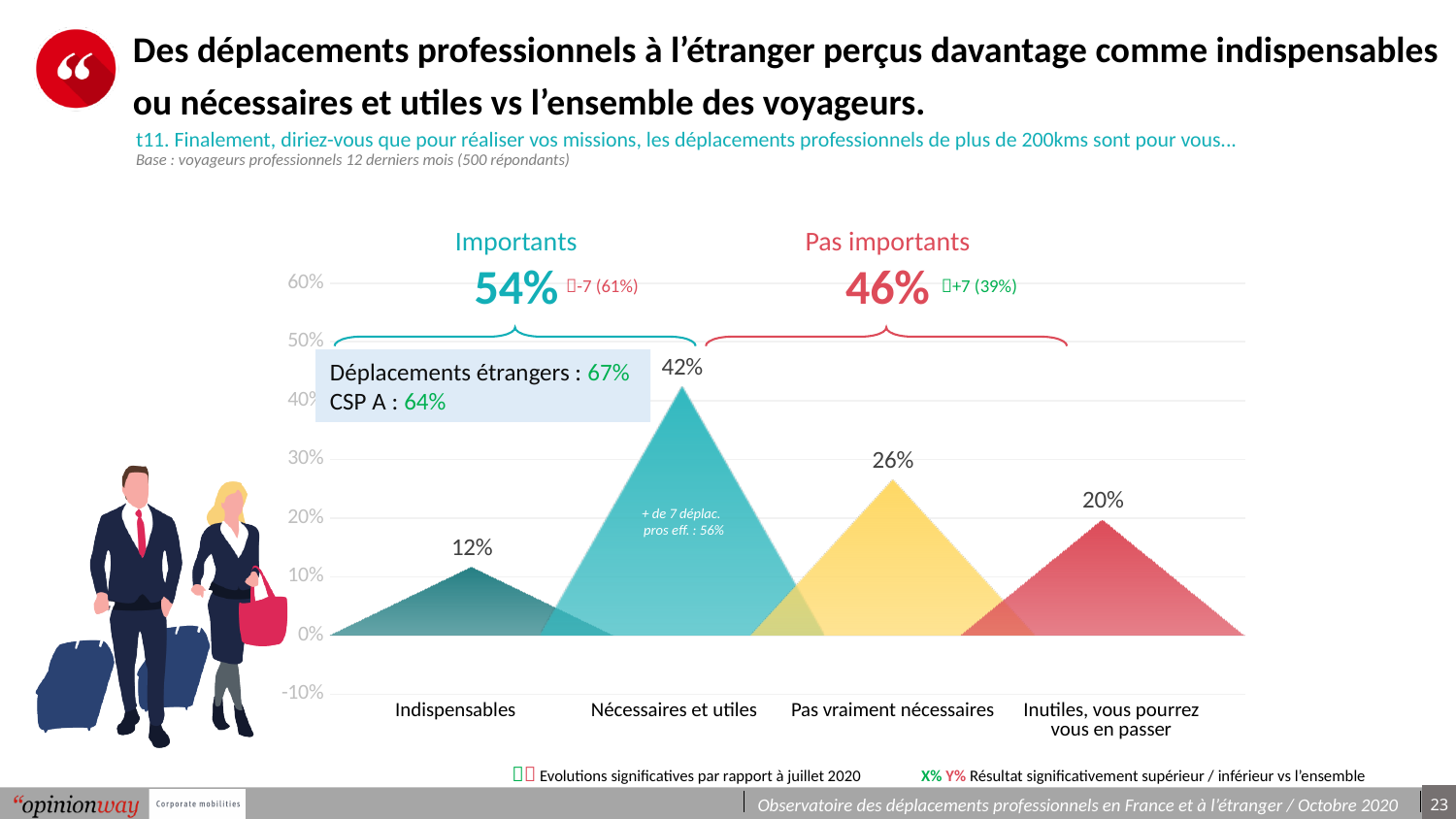
What is the value for "Indispensables"? 12% What is the value for "Pas vraiment nécessaires"? 26% What is the value for "Inutiles, vous pourrez vous en passer"? 20% How many categories are shown on the x axis? 4 What is the difference between the values for "Nécessaires et utiles" and "Pas vraiment nécessaires"? 16% What is the value for "Nécessaires et utiles"? 42% Which category has the lowest value? Indispensables Which category has the highest value? Nécessaires et utiles What is the combined share labelled "Importants"? 54% What is the combined share labelled "Pas importants"? 46% What is the value for "Déplacements étrangers" shown in the callout box? 67% Which is larger, the value for "Pas vraiment nécessaires" or the value for "Inutiles, vous pourrez vous en passer"? Pas vraiment nécessaires